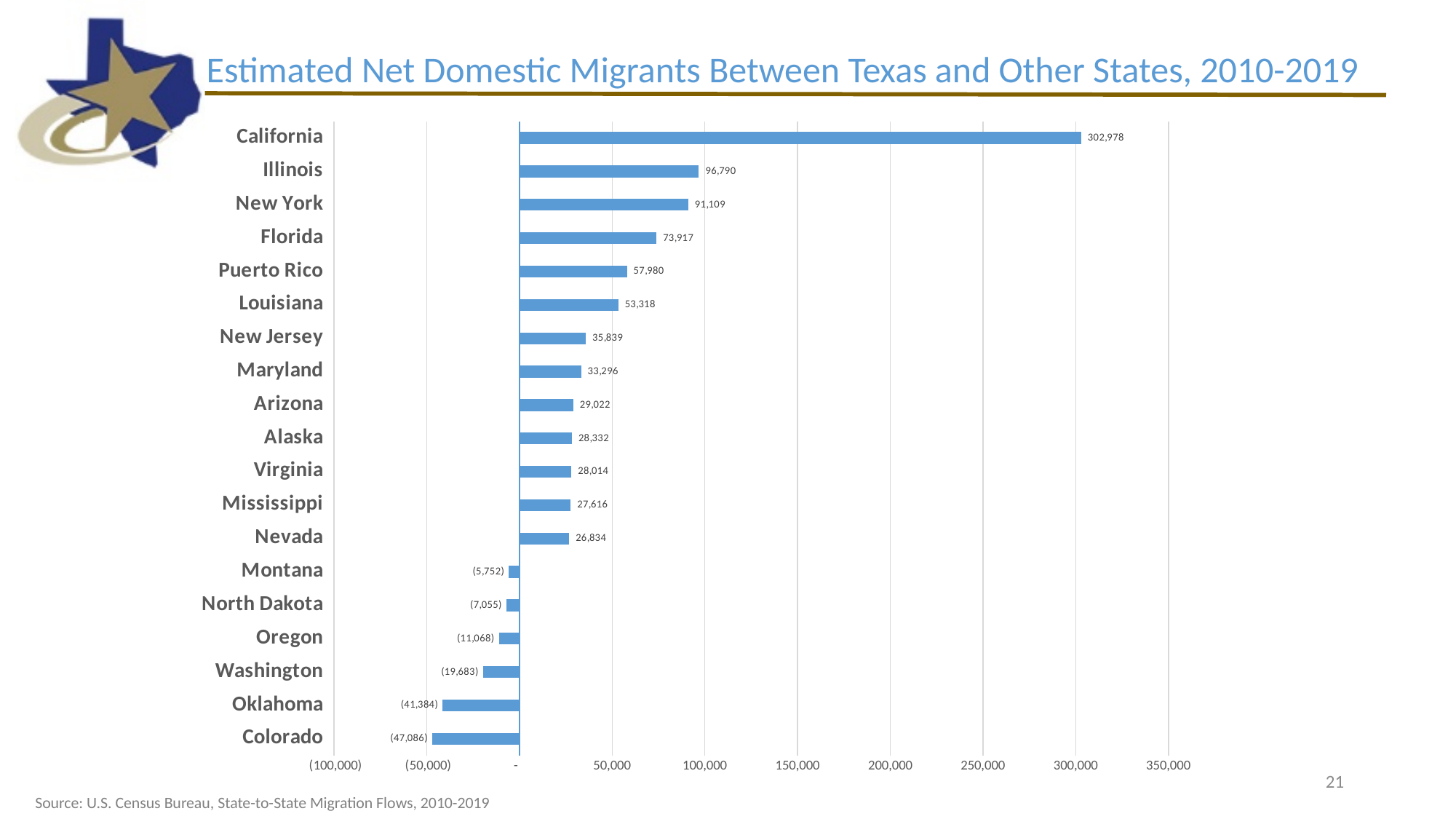
What is the estimated net domestic migration value for California? 302,978 What is the value shown for Colorado? (47,086) How many categories on the chart have negative values? 6 What is the value shown for Louisiana? 53,318 Which state has the highest net domestic migration to Texas? California Which state has the lowest (most negative) value on the chart? Colorado Which has a larger value, Florida or Puerto Rico? Florida What kind of chart is shown on the slide? bar chart Is the value for New Jersey greater or less than 50,000? less What is the title of the chart? Estimated Net Domestic Migrants Between Texas and Other States, 2010-2019 What is the difference between the values for Illinois and New York? 5,681 How many states or territories are shown on the chart? 19